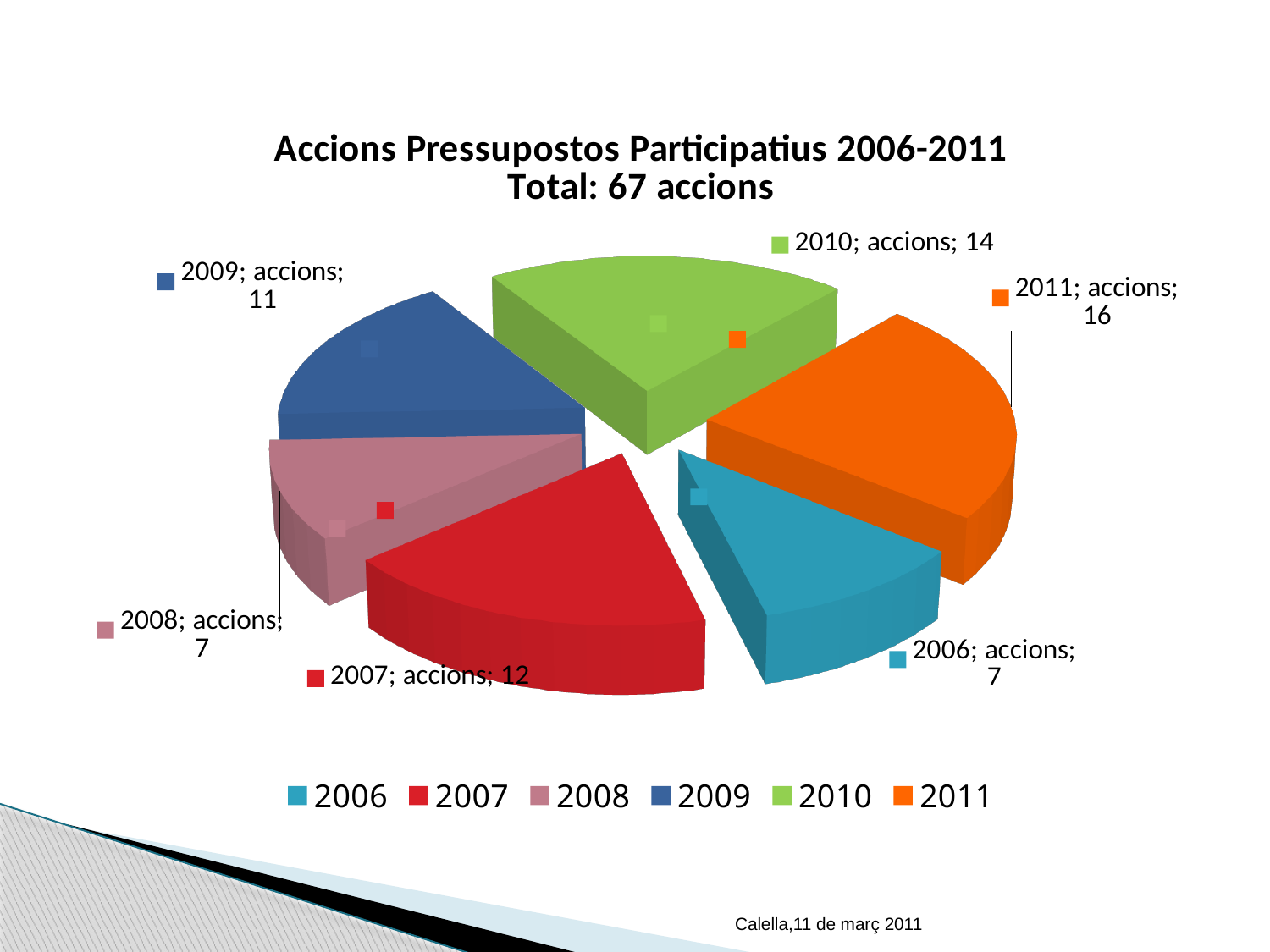
How many accions are shown for 2007? 12 What is the title of the chart? Accions Pressupostos Participatius 2006-2011 Total: 67 accions What share of the total accions does 2011 represent, as a fraction? 16/67 Which year has the highest number of accions? 2011 Which has more accions, 2009 or 2010? 2010 How many accions are shown for 2011? 16 What is the difference in accions between 2011 and 2010? 2 How many accions are shown for 2009? 11 What type of chart is shown on the slide? Pie chart How many slices does the pie chart have? 6 Which years are tied for the lowest number of accions? 2006 and 2008 What is the difference in accions between 2007 and 2006? 5